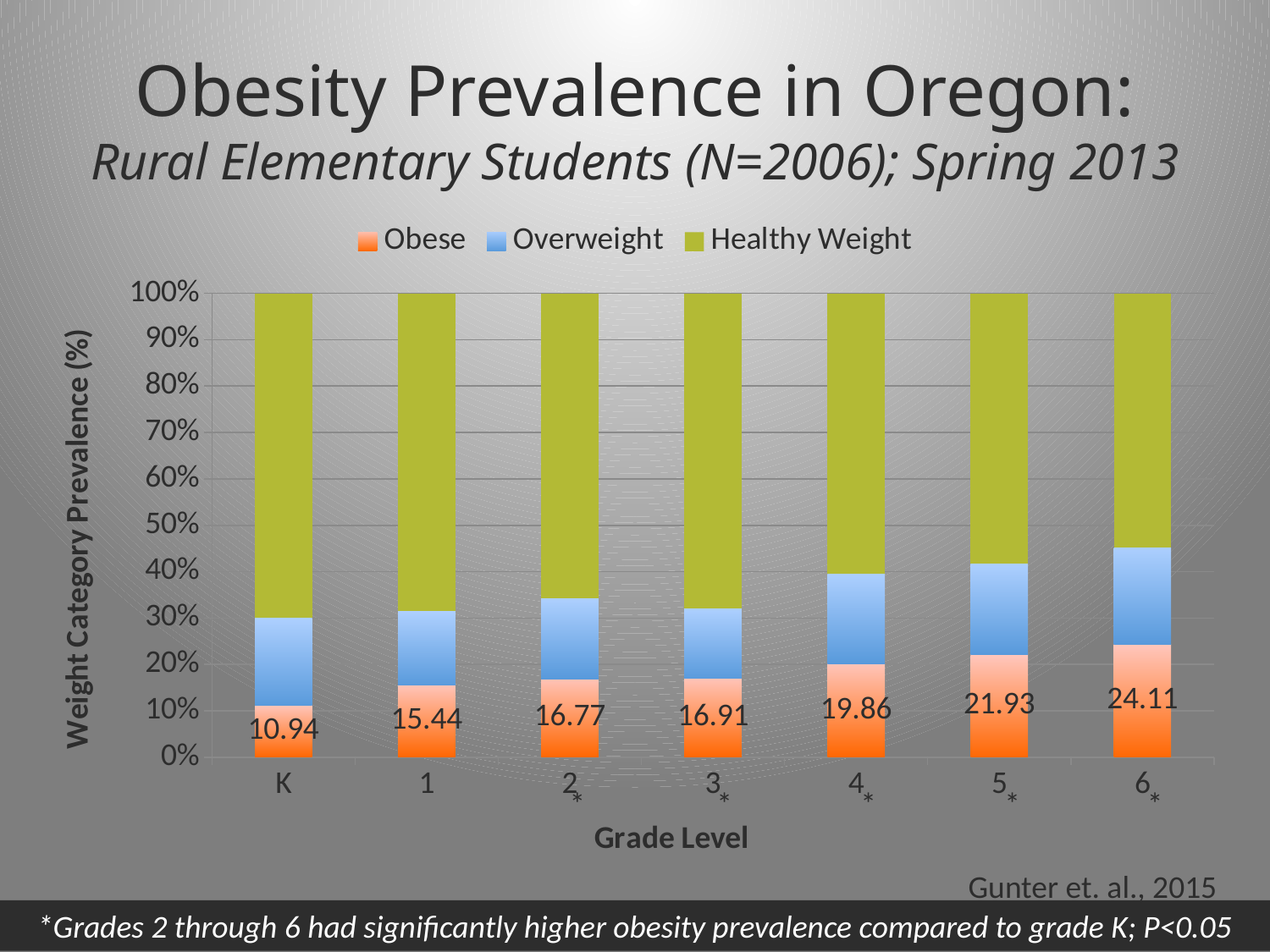
Which grade level has the highest Obese value? 6 How many series does the legend list? 3 How many grade levels are shown on the x axis? 7 Do the Obese values rise or fall from grade K to grade 6? rise What kind of chart is shown on the slide? stacked bar chart Is the Healthy Weight share for grade K greater or less than 60%? greater What is the Obese value for grade 6? 24.11 What is the difference between the Obese values for grade 6 and grade K? 13.17 Which has a larger Obese value, grade 1 or grade 5? grade 5 What is the Obese value for grade 4? 19.86 What is the Obese value for grade K? 10.94 Which grade level has the lowest Obese value? K